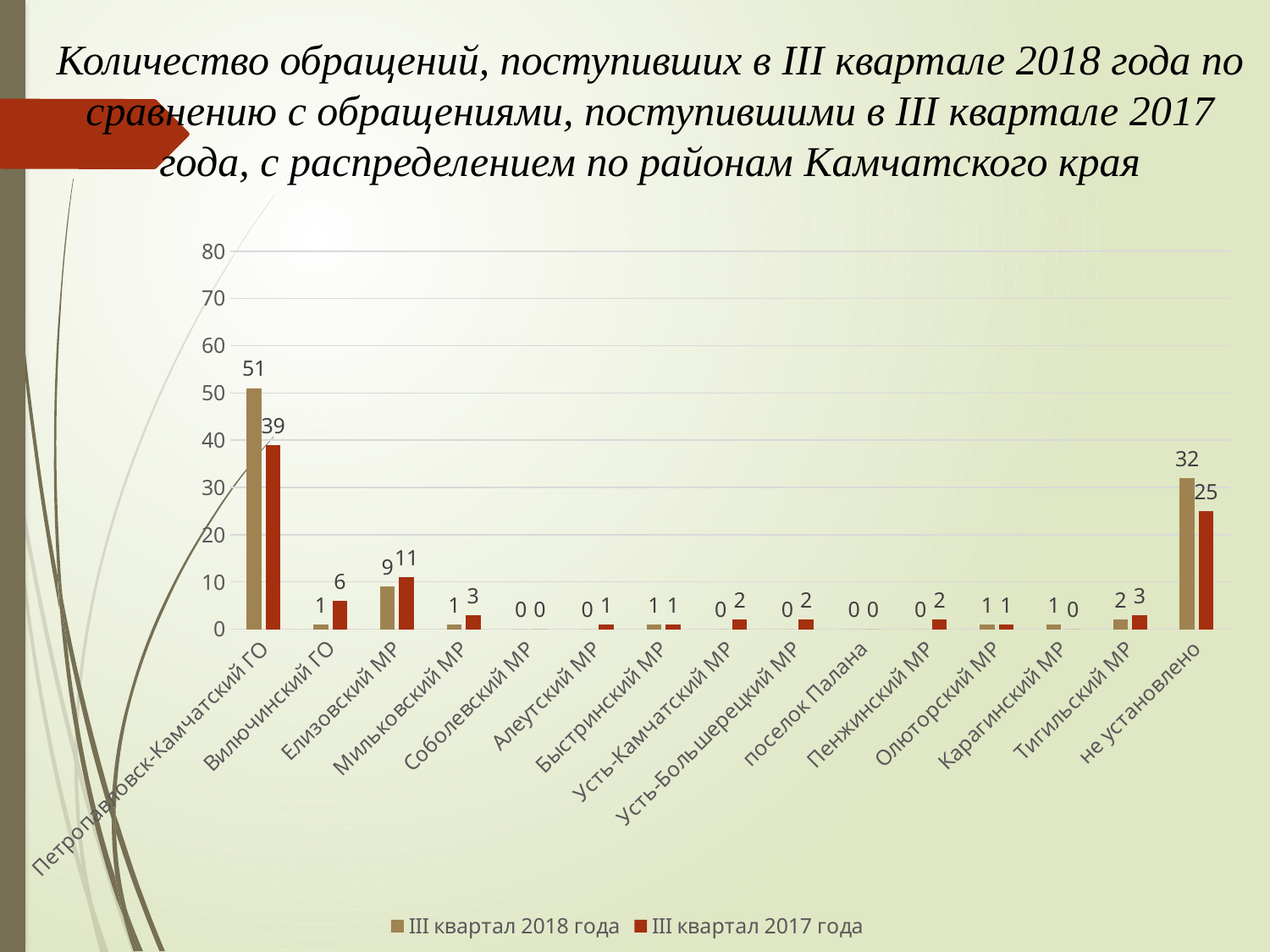
For Вилючинский ГО, which series has the larger value: III квартал 2018 года or III квартал 2017 года? III квартал 2017 года What is the value for Елизовский МР in the III квартал 2017 года series? 11 What is the value for не установлено in the III квартал 2017 года series? 25 What is the difference between the III квартал 2018 года and III квартал 2017 года values for Петропавловск-Камчатский ГО? 12 How many categories are shown on the x axis? 15 Is the value for Петропавловск-Камчатский ГО in the III квартал 2018 года series greater or less than 40? greater What kind of chart is shown on the slide? bar chart Which category has the highest value in the III квартал 2018 года series? Петропавловск-Камчатский ГО What is the value for Петропавловск-Камчатский ГО in the III квартал 2018 года series? 51 What is the difference between the III квартал 2018 года and III квартал 2017 года values for не установлено? 7 What is the value for Тигильский МР in the III квартал 2017 года series? 3 How many series does the legend list? 2